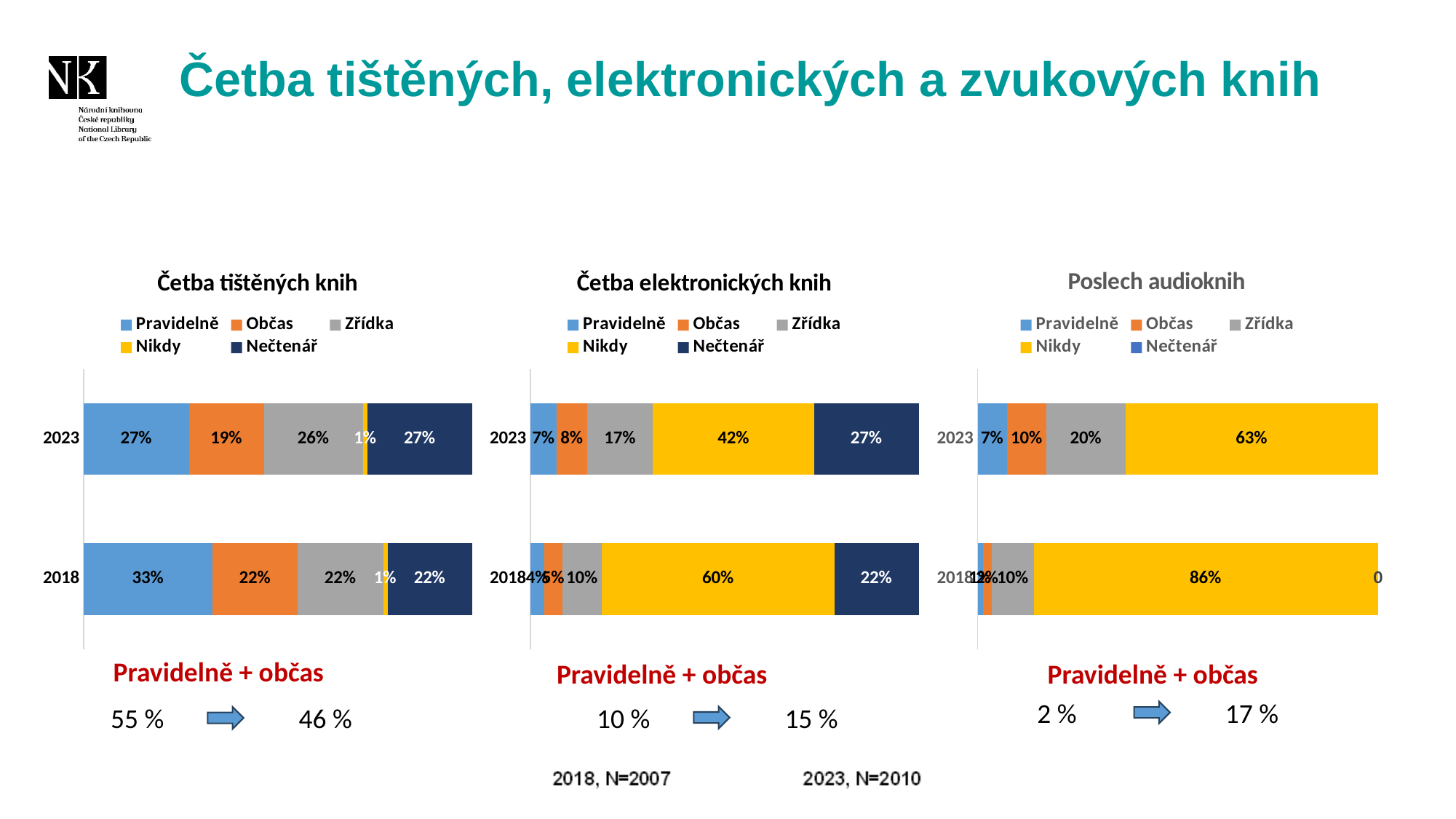
In the 'Poslech audioknih' chart, which is larger in 2023: Zřídka or Občas? Zřídka In the 'Četba elektronických knih' chart, what is the value for Nikdy in 2023? 42% In the 'Poslech audioknih' chart, what is the value for Nikdy in 2018? 86% In the 'Četba tištěných knih' chart, what is the value for Pravidelně in 2023? 27% In the 'Četba elektronických knih' chart, what is the value for Nikdy in 2018? 60% In the 'Četba tištěných knih' chart, what is the value for Pravidelně in 2018? 33% What kind of chart is 'Poslech audioknih'? Stacked bar chart In the 'Četba elektronických knih' chart, which segment is the largest in the 2023 bar? Nikdy In the 'Četba tištěných knih' chart, by how many percentage points did Pravidelně fall from 2018 to 2023? 6 percentage points How many series does the legend of the 'Četba tištěných knih' chart list? 5 How many years (bars) are shown in the 'Četba elektronických knih' chart? 2 In the 'Poslech audioknih' chart, what is the value for Nikdy in 2023? 63%